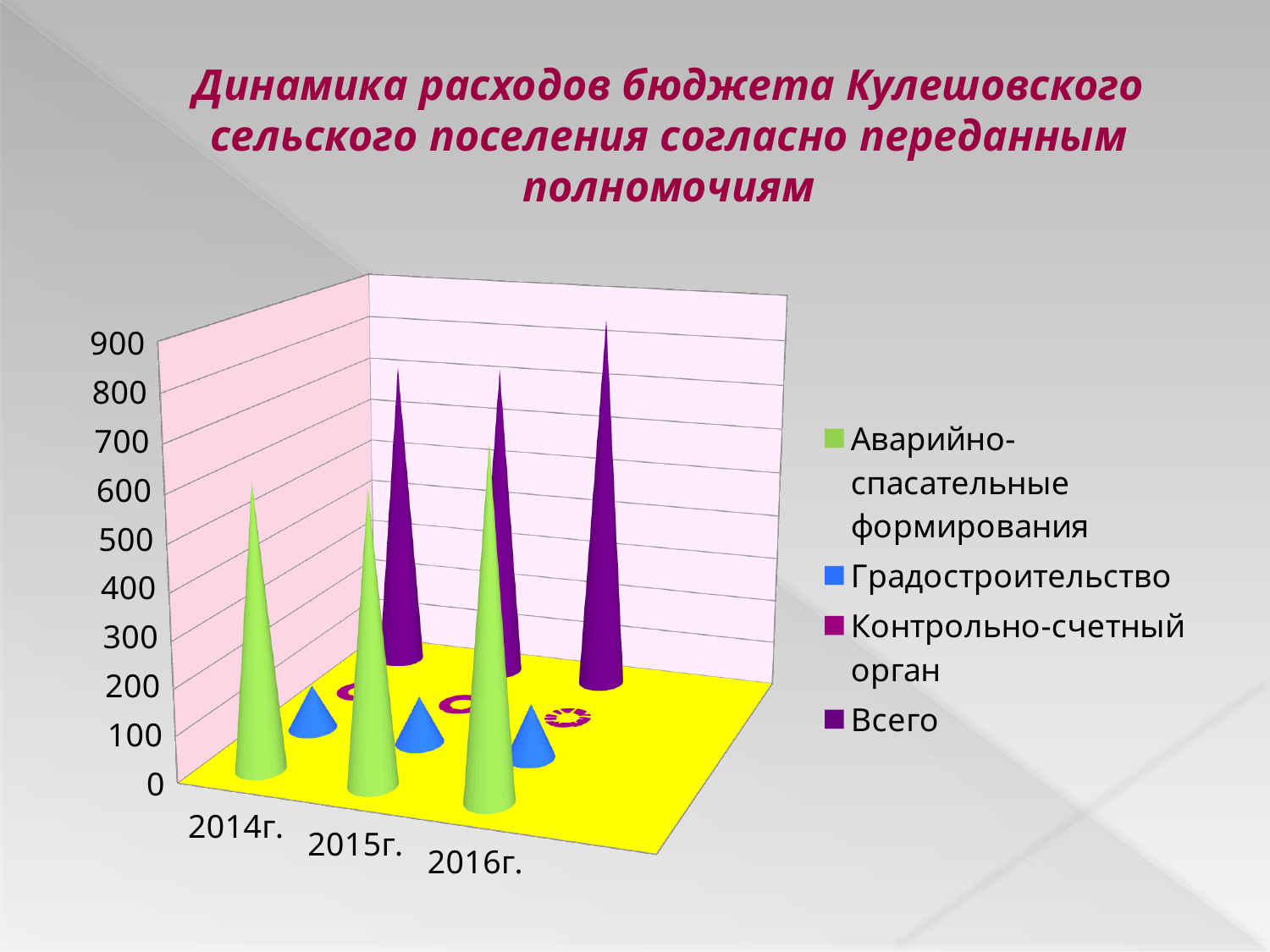
Is the value for Аварийно-спасательные формирования in 2016г. greater or less than 300? greater What kind of chart is shown on the slide? bar chart Which is larger in 2016г.: the value for Всего or the value for Градостроительство? Всего What is the last legend entry of the chart? Всего Is the value for Всего in 2016г. greater or less than 500? greater Which series is shown in green in the legend? Аварийно-спасательные формирования Is the value for Градостроительство in 2014г. greater or less than 300? less Which year has the highest value for the series Всего? 2016г. How many years are shown on the x axis of the chart? 3 Do the values for the series Всего rise or fall from 2014г. to 2016г.? rise How many series does the chart legend list? 4